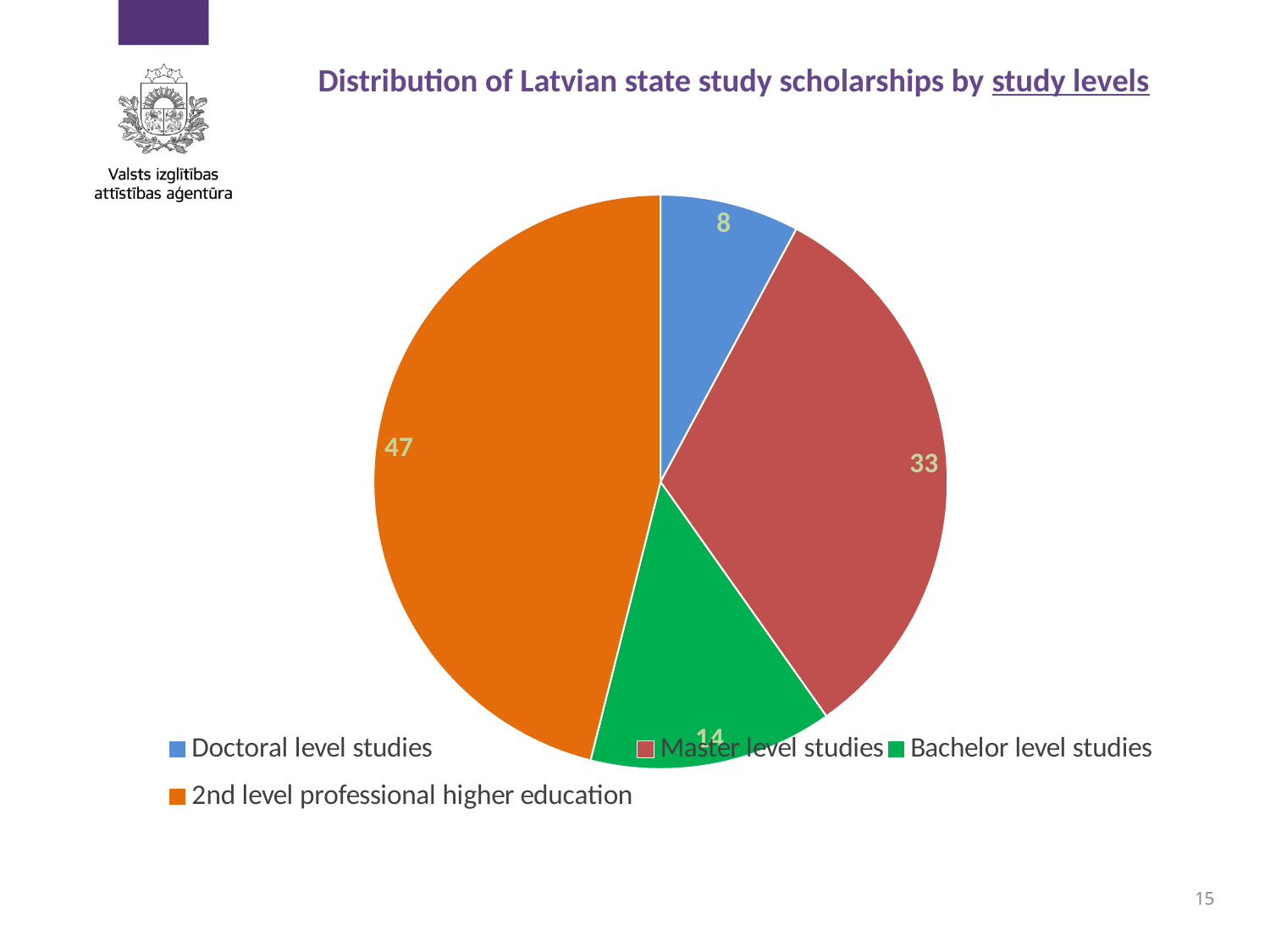
Which is larger, the value for Master level studies or the value for Bachelor level studies? Master level studies What is the value for Bachelor level studies? 14 What is the value for 2nd level professional higher education? 47 What is the value for Master level studies? 33 Which study level has the largest slice of the pie? 2nd level professional higher education What is the value for Doctoral level studies? 8 What is the difference between the values for 2nd level professional higher education and Master level studies? 14 What is the difference between the values for Bachelor level studies and Doctoral level studies? 6 How many study levels are shown in the pie chart? 4 Which study level has the smallest slice of the pie? Doctoral level studies What colour is the slice for Bachelor level studies? Green What type of chart is shown on the slide? Pie chart